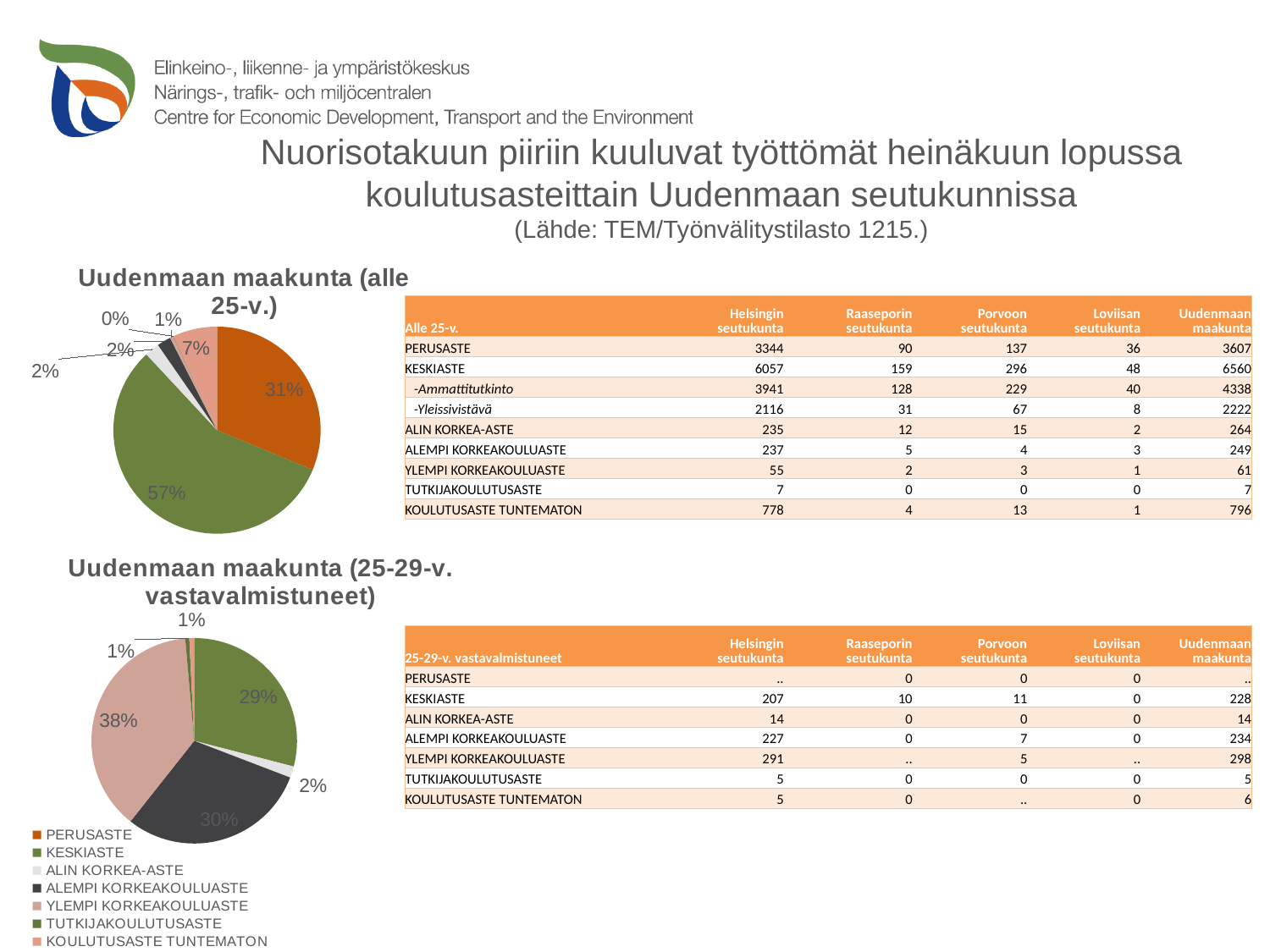
In the "Uudenmaan maakunta (alle 25-v.)" pie chart, which is larger: the KESKIASTE slice or the PERUSASTE slice? KESKIASTE In the "Uudenmaan maakunta (25-29-v. vastavalmistuneet)" pie chart, what share does the KESKIASTE slice have? 29% How many categories does the shared legend of the pie charts list? 7 What is the title of the upper pie chart on the slide? Uudenmaan maakunta (alle 25-v.) In the "Uudenmaan maakunta (alle 25-v.)" pie chart, what is the difference in percentage points between the 57% slice and the 31% slice? 26 In the "Uudenmaan maakunta (alle 25-v.)" pie chart, what is the largest slice's share? 57% In the "Uudenmaan maakunta (alle 25-v.)" pie chart, what share does the orange PERUSASTE slice have? 31% In the "Uudenmaan maakunta (25-29-v. vastavalmistuneet)" pie chart, what share does the ALIN KORKEA-ASTE slice have? 2% What kind of chart is "Uudenmaan maakunta (alle 25-v.)"? pie chart In the "Uudenmaan maakunta (25-29-v. vastavalmistuneet)" pie chart, what is the largest slice's share? 38%